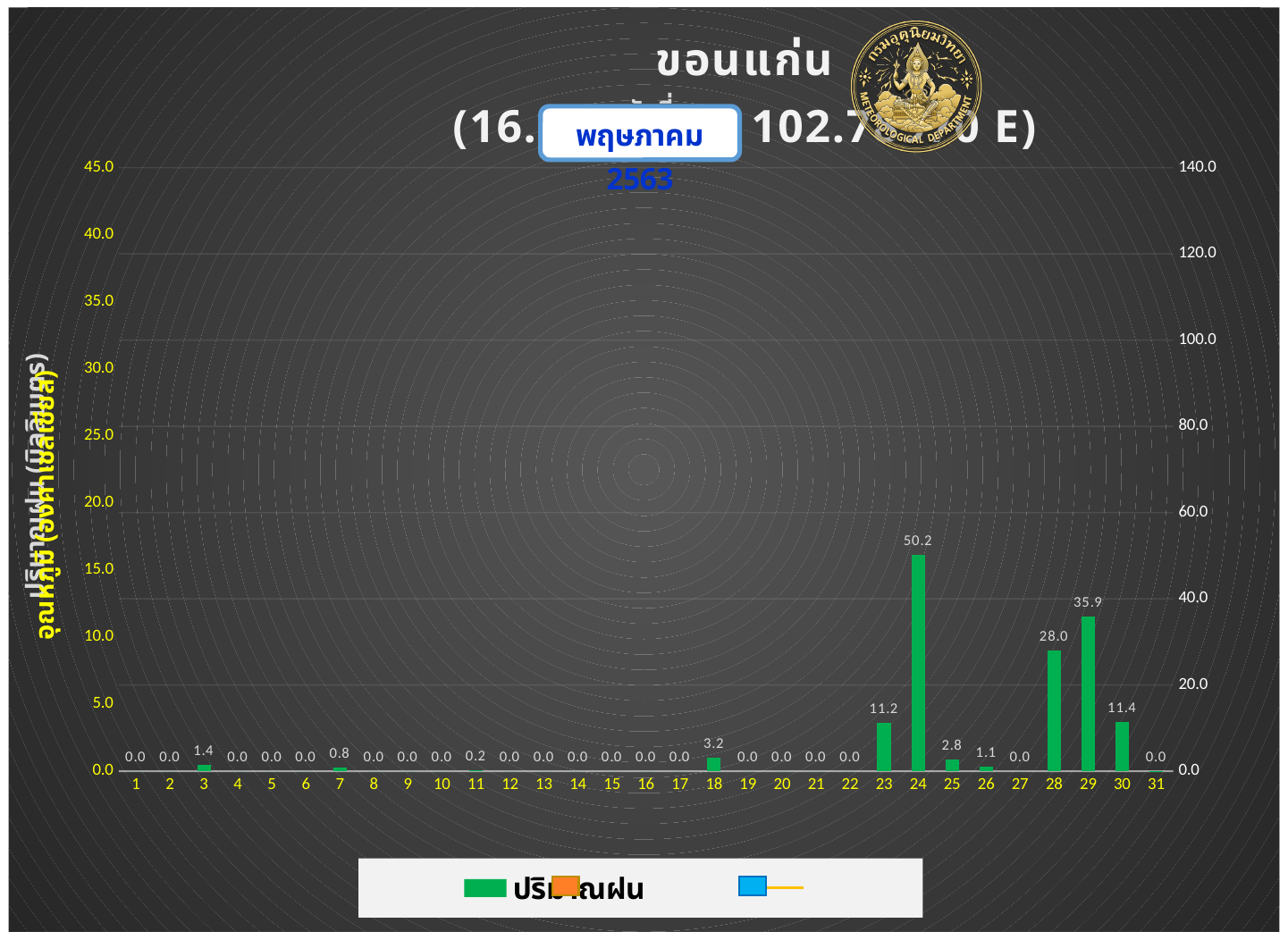
What is the difference between the rainfall values for day 24 and day 29? 14.3 What colour are the rainfall bars in the chart? green What is the difference between the rainfall values for day 28 and day 23? 16.8 What is the rainfall value shown for day 29? 35.9 What is the rainfall value shown for day 18? 3.2 What is the rainfall value shown for day 24? 50.2 What kind of chart is shown on the slide? bar chart What is the rainfall value shown for day 3? 1.4 What is the rainfall value shown for day 28? 28.0 Which is larger, the rainfall value for day 23 or for day 30? day 30 How many days are shown on the x axis? 31 Which day has the highest rainfall value? 24